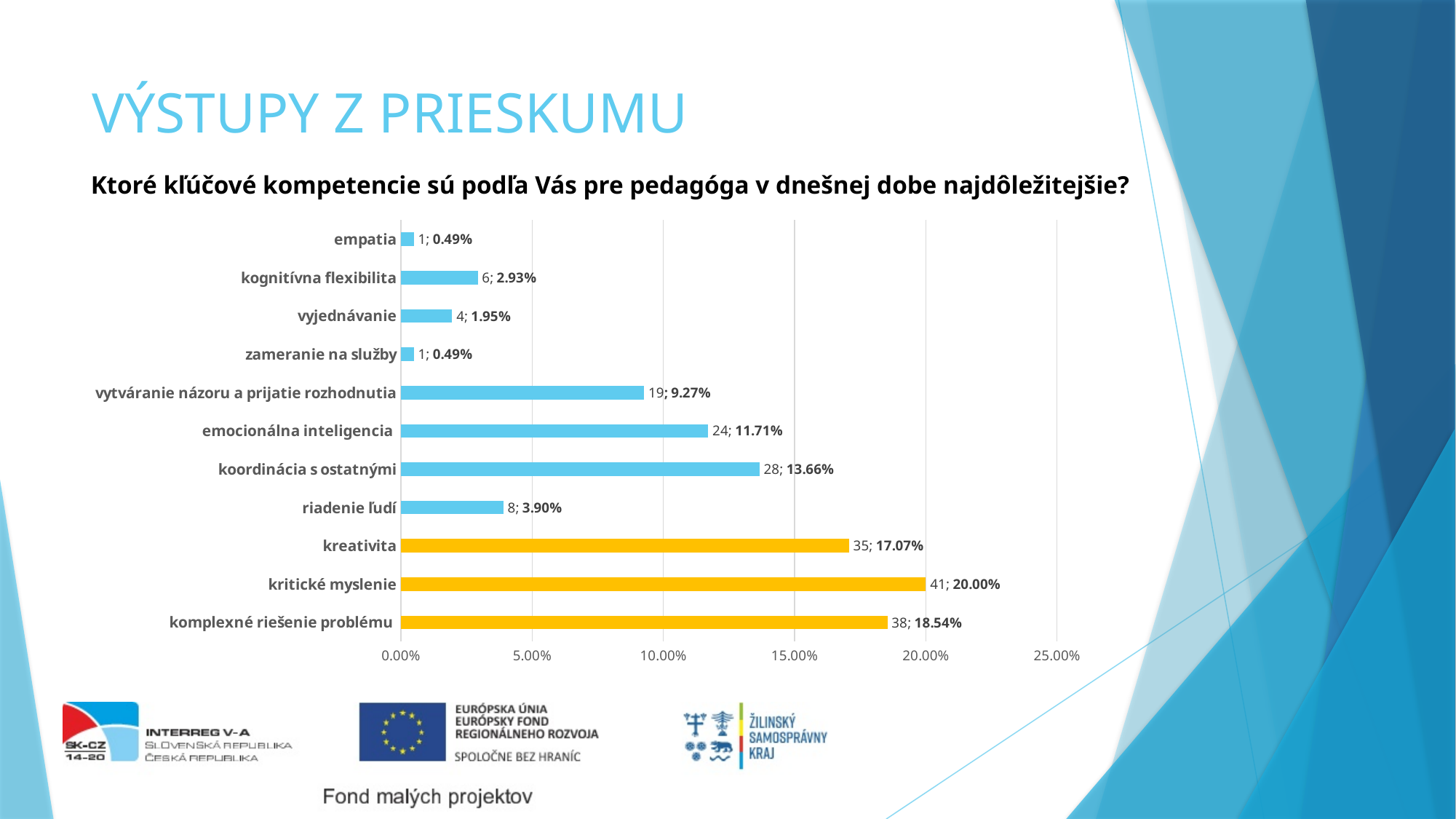
How many responses (count) are shown for koordinácia s ostatnými? 28 Which categories share the lowest value of 0.49%? empatia and zameranie na služby What percentage is shown for kritické myslenie? 20.00% How many categories are plotted in the chart? 11 Which is larger, the value for koordinácia s ostatnými or for emocionálna inteligencia? koordinácia s ostatnými What is the difference in count between kritické myslenie (41) and kreativita (35)? 6 What percentage is shown for emocionálna inteligencia? 11.71% How many bars are coloured orange rather than blue? 3 What is the total count for the three orange bars (kreativita, kritické myslenie, komplexné riešenie problému)? 114 Which category has the highest value? kritické myslenie What kind of chart is shown on the slide? bar chart Is the value for komplexné riešenie problému greater or less than 15.00%? greater